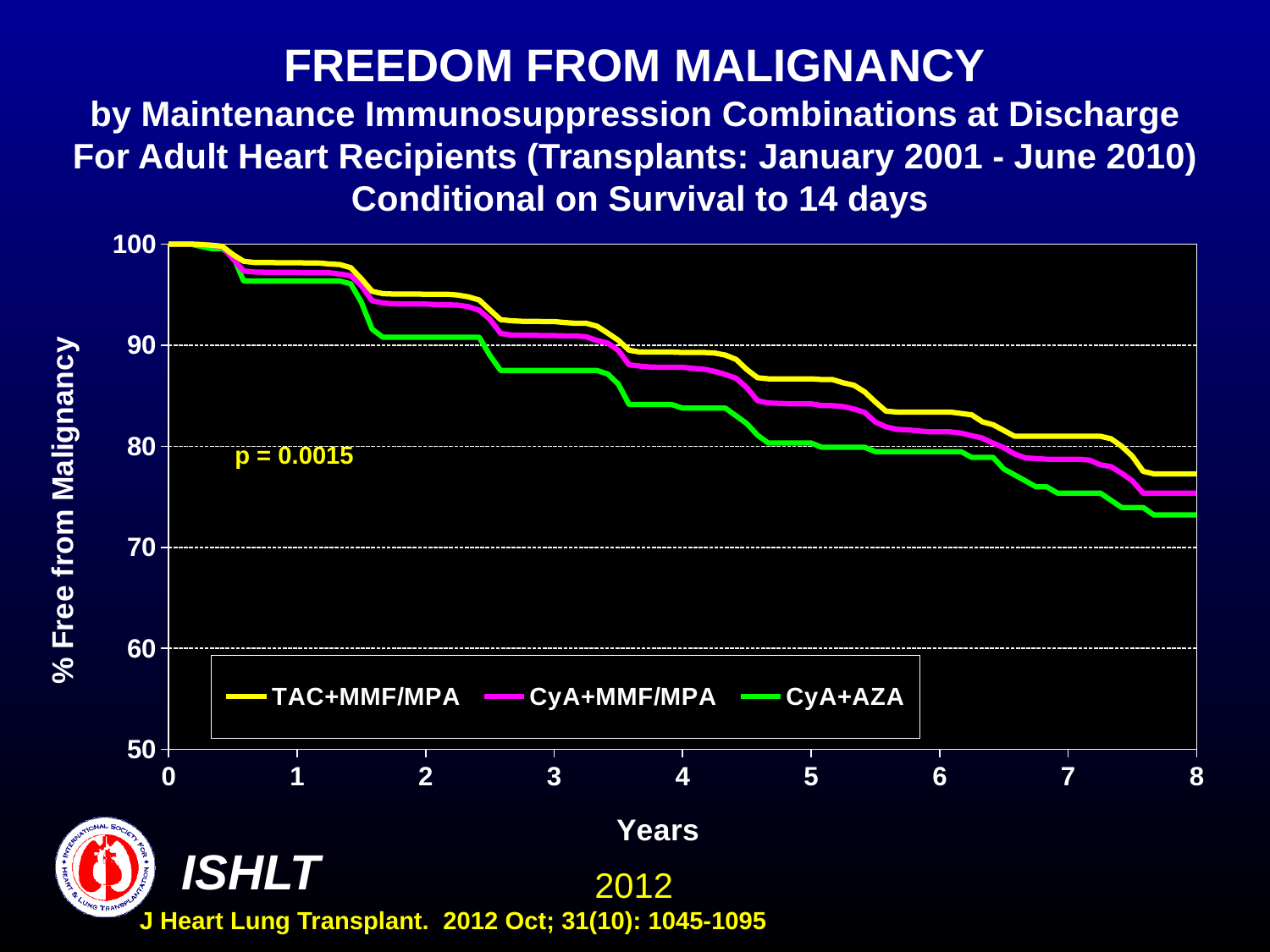
How many series does the legend list? 3 What is the label of the y axis? % Free from Malignancy What p-value is printed on the chart? p = 0.0015 Is the value for CyA+AZA at 3 years greater or less than 90? less Which series has the lowest % free from malignancy at 8 years? CyA+AZA At 3 years, which series is higher: CyA+MMF/MPA or CyA+AZA? CyA+MMF/MPA At 8 years, which series is higher: TAC+MMF/MPA or CyA+AZA? TAC+MMF/MPA Is the value for TAC+MMF/MPA at 8 years greater or less than 80? less Do the curves rise or fall as years increase? fall Is the value for CyA+AZA at 8 years greater or less than 70? greater Which series has the highest % free from malignancy at 8 years? TAC+MMF/MPA What kind of chart is shown on the slide? line chart